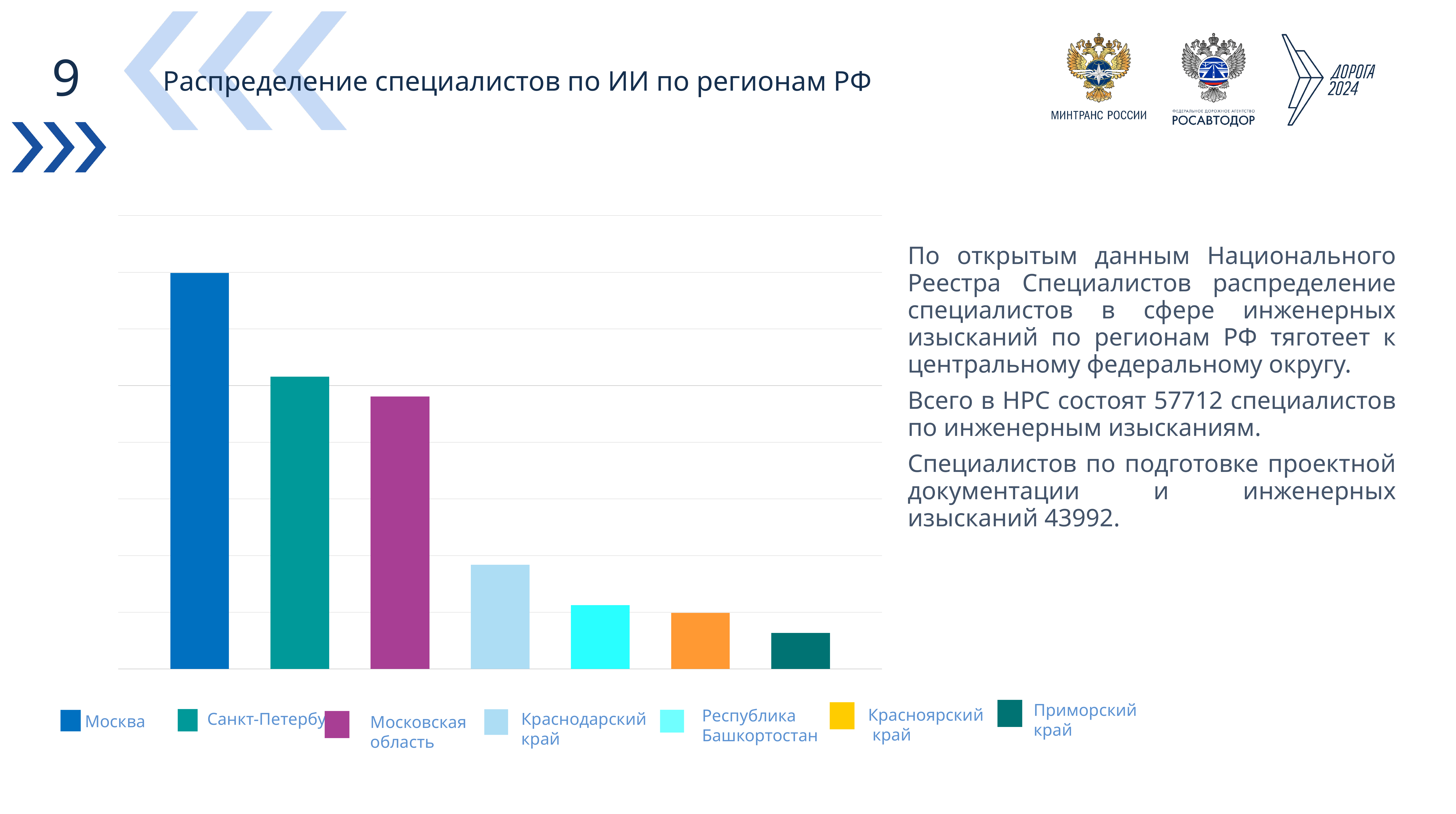
Which has the larger value, Краснодарский край or Республика Башкортостан? Краснодарский край How many entries does the chart legend list? 7 Do the bar values rise or fall from left to right across the chart? Fall Which has the larger value, Санкт-Петербург or Московская область? Санкт-Петербург Which region has the lowest bar in the chart? Приморский край Which region is the second highest in the chart? Санкт-Петербург Which has the larger value, Московская область or Краснодарский край? Московская область Which region has the highest bar in the chart? Москва What kind of chart is shown on the slide? Bar chart How many regions (bars) are plotted in the chart? 7 What is the title of the slide containing the chart? Распределение специалистов по ИИ по регионам РФ